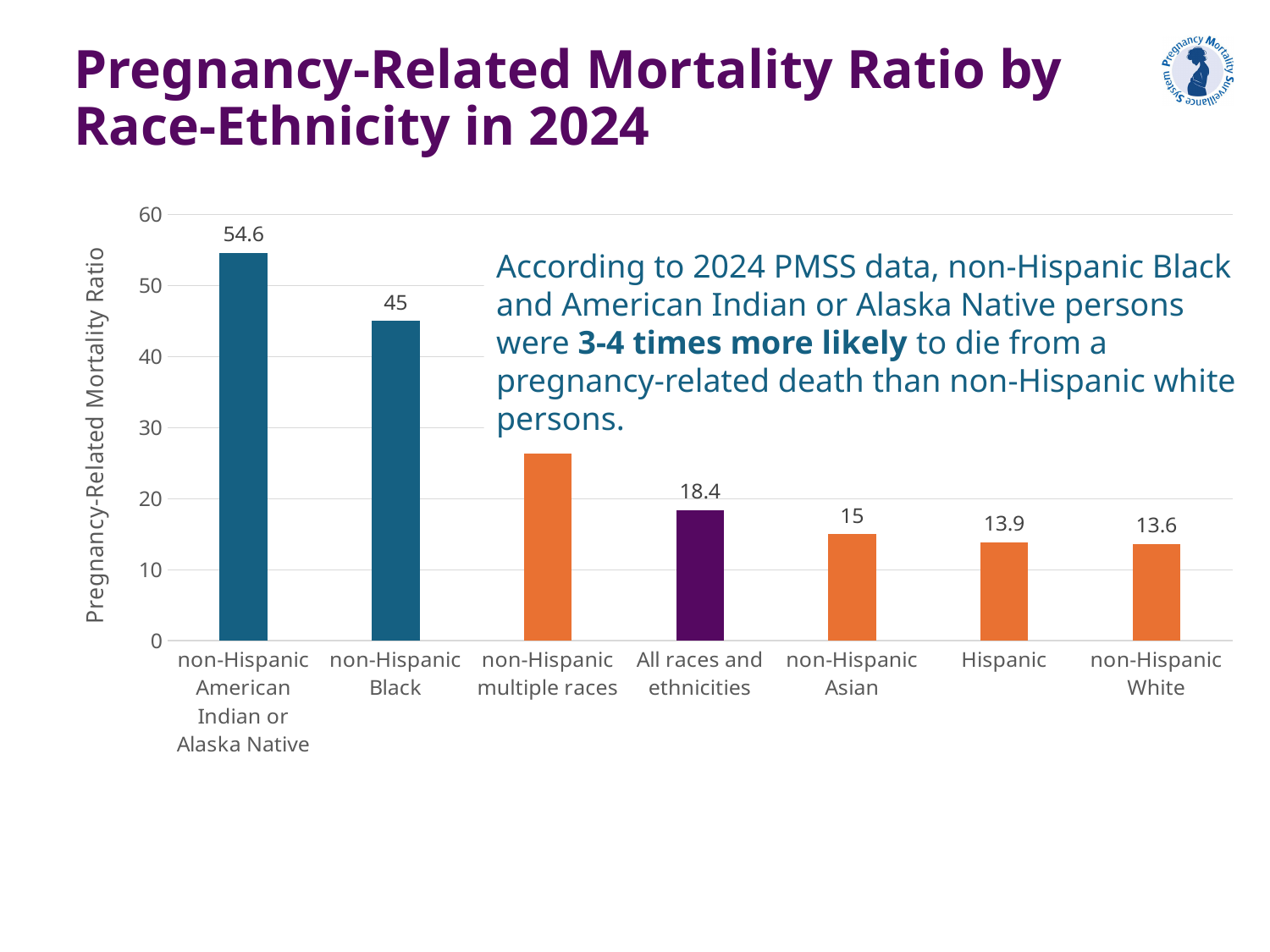
What is the pregnancy-related mortality ratio for non-Hispanic Black persons? 45 What is the label of the vertical axis of the chart? Pregnancy-Related Mortality Ratio Which race-ethnicity group has the highest pregnancy-related mortality ratio? non-Hispanic American Indian or Alaska Native What is the pregnancy-related mortality ratio for non-Hispanic White persons? 13.6 Which race-ethnicity group has the lowest pregnancy-related mortality ratio? non-Hispanic White What kind of chart is shown on the slide? bar chart Is the value for non-Hispanic multiple races greater or less than 20? greater What is the pregnancy-related mortality ratio for non-Hispanic American Indian or Alaska Native persons? 54.6 Which has a higher pregnancy-related mortality ratio, non-Hispanic Asian or Hispanic? non-Hispanic Asian What is the difference between the pregnancy-related mortality ratio for non-Hispanic American Indian or Alaska Native persons and non-Hispanic Black persons? 9.6 What is the pregnancy-related mortality ratio for All races and ethnicities? 18.4 How many race-ethnicity categories are shown in the chart? 7